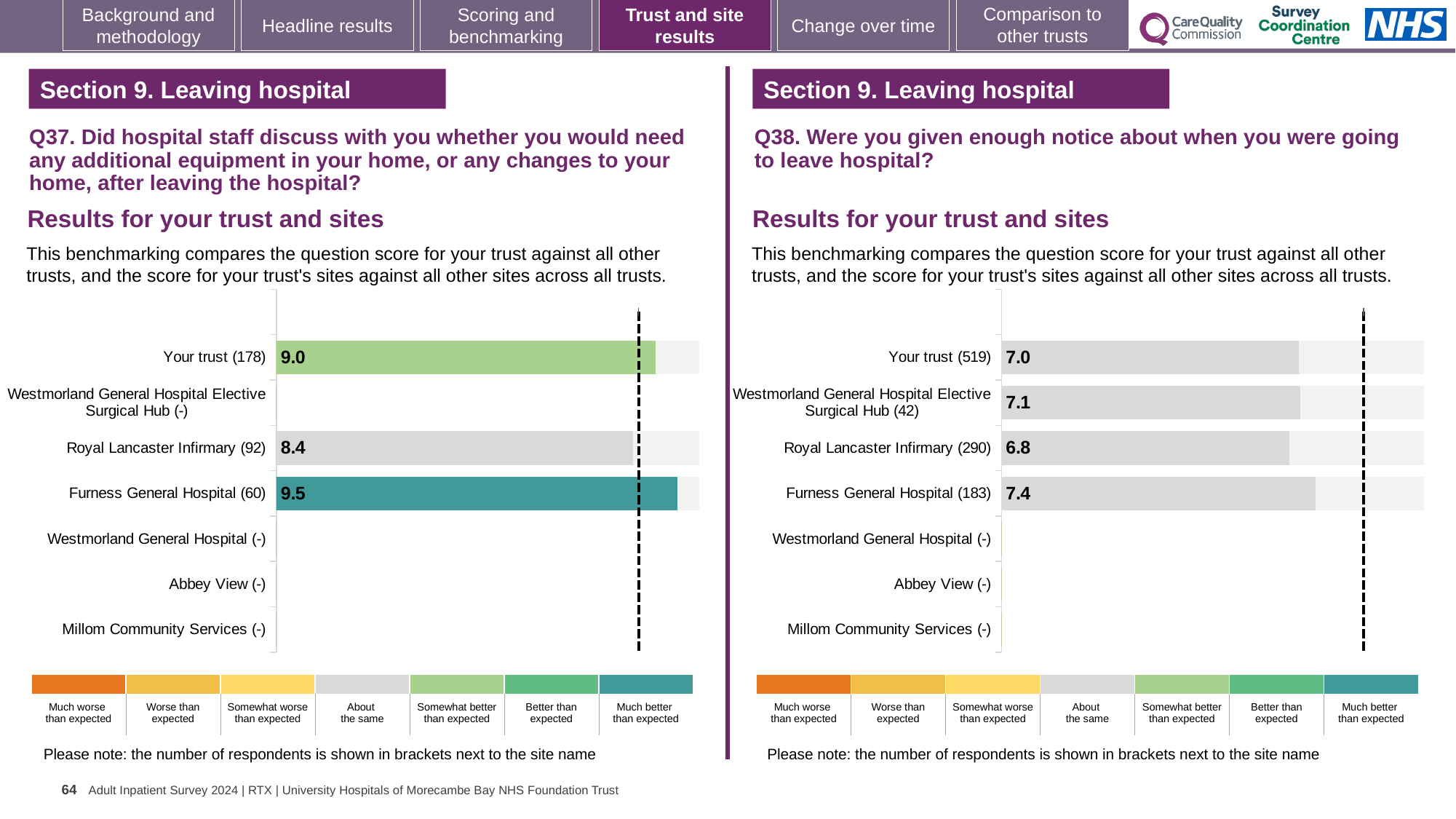
What type of chart is used for the Q38 results on the right? Bar chart In the Q38 chart on the right, what is the score for Westmorland General Hospital Elective Surgical Hub (42)? 7.1 In the Q37 chart on the left, what is the score for Furness General Hospital (60)? 9.5 In the Q38 chart on the right, what is the difference between the scores for Furness General Hospital and Your trust? 0.4 In the Q38 chart on the right, what is the score for Royal Lancaster Infirmary (290)? 6.8 In the Q37 chart on the left, what is the score for Your trust (178)? 9.0 In the Q37 chart on the left, which site has the highest score? Furness General Hospital (60) In the Q38 chart on the right, which is larger: the score for Furness General Hospital or the score for Your trust? Furness General Hospital In the Q37 chart on the left, what is the difference between the scores for Furness General Hospital and Royal Lancaster Infirmary? 1.1 In the Q38 chart on the right, which site has the lowest score? Royal Lancaster Infirmary (290) How many site/trust categories are listed on the y axis of the Q37 chart on the left? 7 In the Q37 chart on the left, which benchmark category does the colour of the Furness General Hospital bar correspond to in the legend? Much better than expected